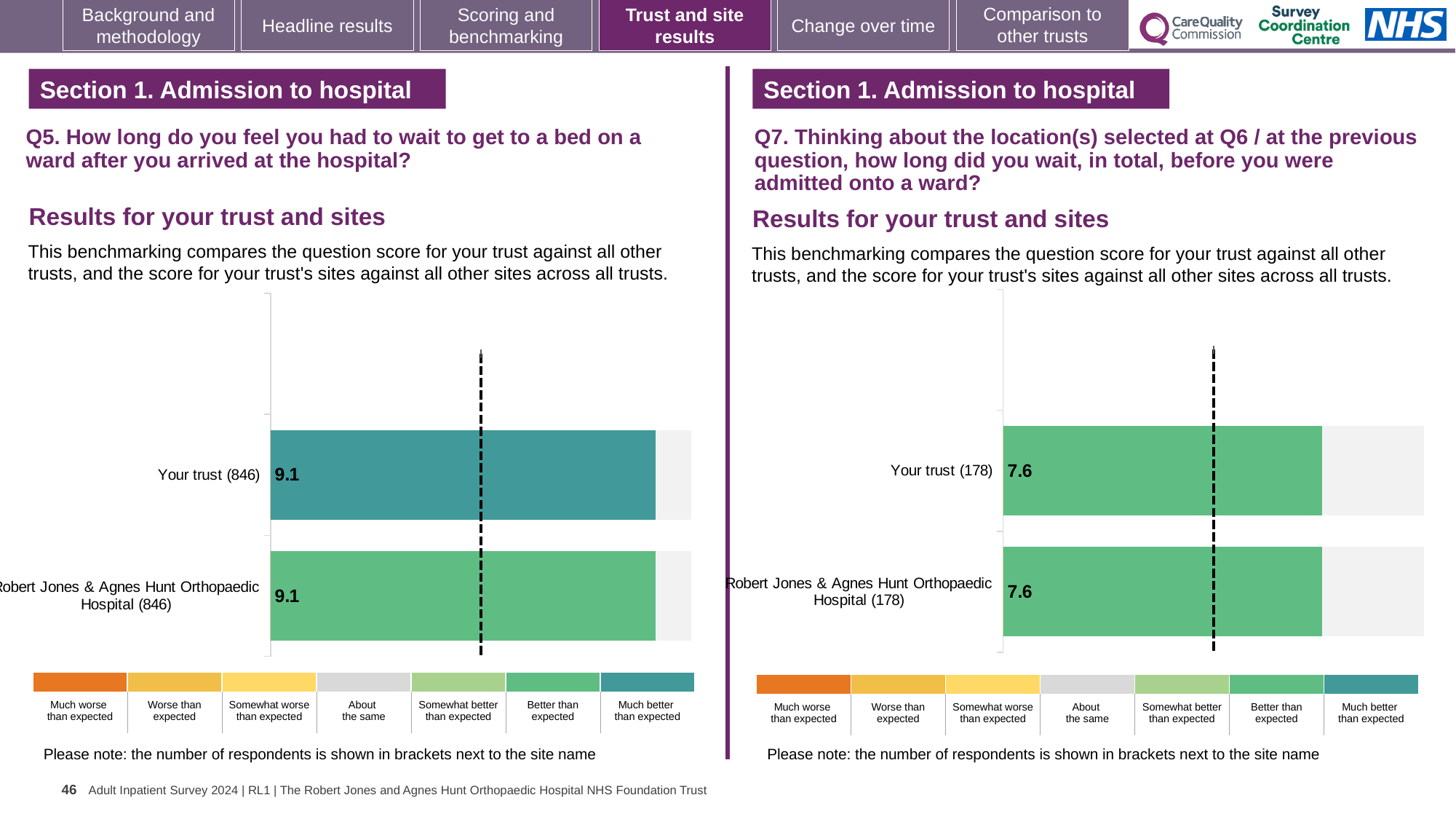
On the left chart (Q5), what is the score for Your trust? 9.1 On the right chart (Q7), how many respondents are shown in brackets next to Robert Jones & Agnes Hunt Orthopaedic Hospital? 178 On the left chart (Q5), what is the difference between the score for Your trust and the score for Robert Jones & Agnes Hunt Orthopaedic Hospital? 0 On the right chart (Q7), what is the score for Your trust? 7.6 Is the score for Your trust on the left chart (Q5) larger or smaller than the score for Your trust on the right chart (Q7)? Larger On the left chart (Q5), how many respondents are shown in brackets next to Your trust? 846 On the left chart (Q5), what is the score for Robert Jones & Agnes Hunt Orthopaedic Hospital? 9.1 What kind of chart is used on the left (Q5)? Bar chart How many bars are plotted on the left chart (Q5)? 2 On the right chart (Q7), what is the difference between the score for Your trust and the score for Robert Jones & Agnes Hunt Orthopaedic Hospital? 0 On the right chart (Q7), what is the score for Robert Jones & Agnes Hunt Orthopaedic Hospital? 7.6 How many bars are plotted on the right chart (Q7)? 2